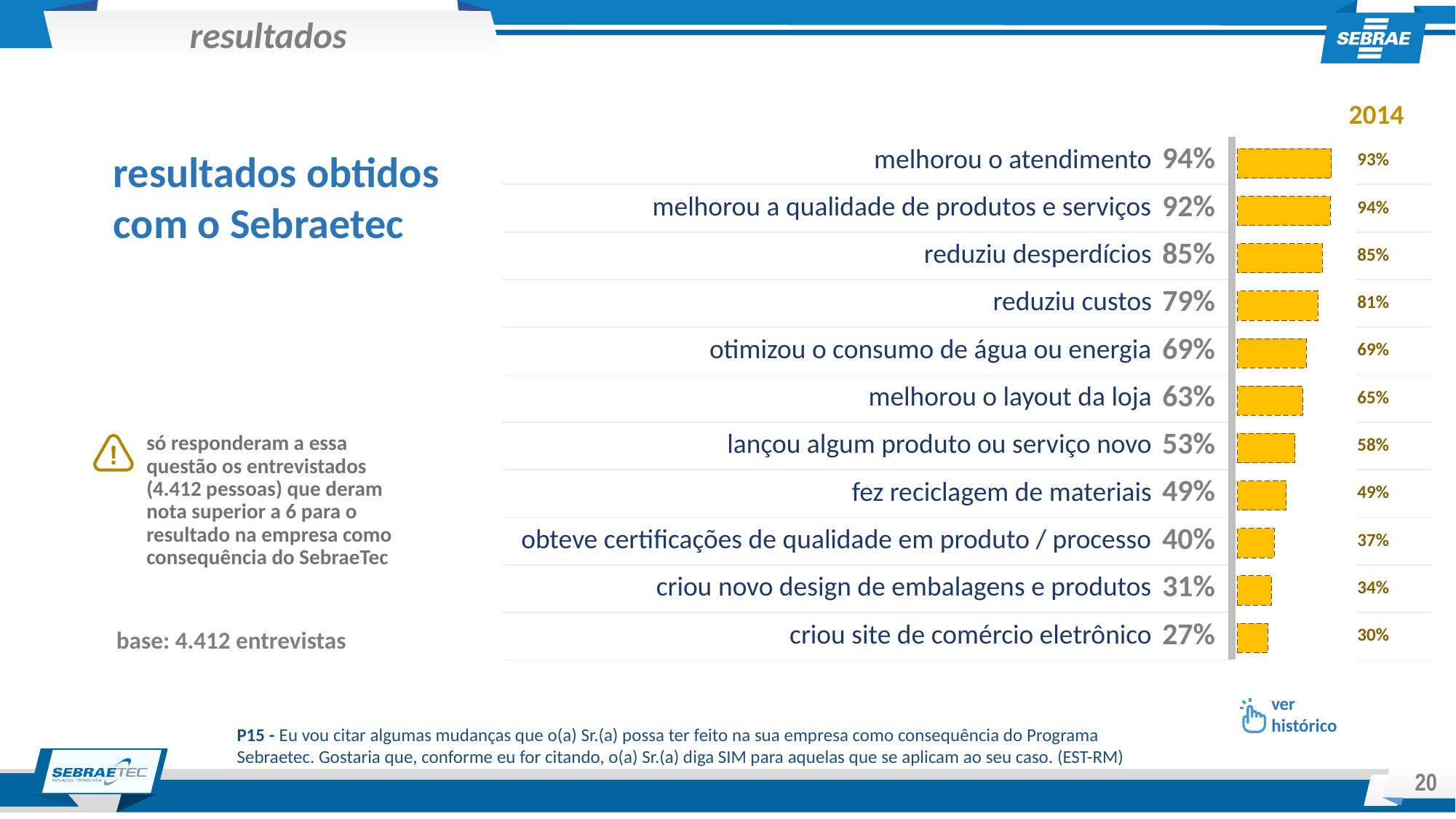
Which category has the lowest value in the chart? criou site de comércio eletrônico What is the difference between the current value and the 2014 value for "lançou algum produto ou serviço novo"? 5% What is the value shown for "reduziu custos"? 79% What is the difference between the values for "reduziu desperdícios" and "reduziu custos"? 6% What is the base (number of interviews) stated for the chart? 4.412 entrevistas What type of chart is shown on the slide? bar chart What is the 2014 value shown for "lançou algum produto ou serviço novo"? 58% Which is larger: the value for "fez reciclagem de materiais" or the value for "obteve certificações de qualidade em produto / processo"? fez reciclagem de materiais Is the current value for "melhorou o layout da loja" higher or lower than its 2014 value? lower What percentage of respondents reported "melhorou o atendimento"? 94% How many categories are shown in the chart? 11 Which category has the highest value in the chart? melhorou o atendimento